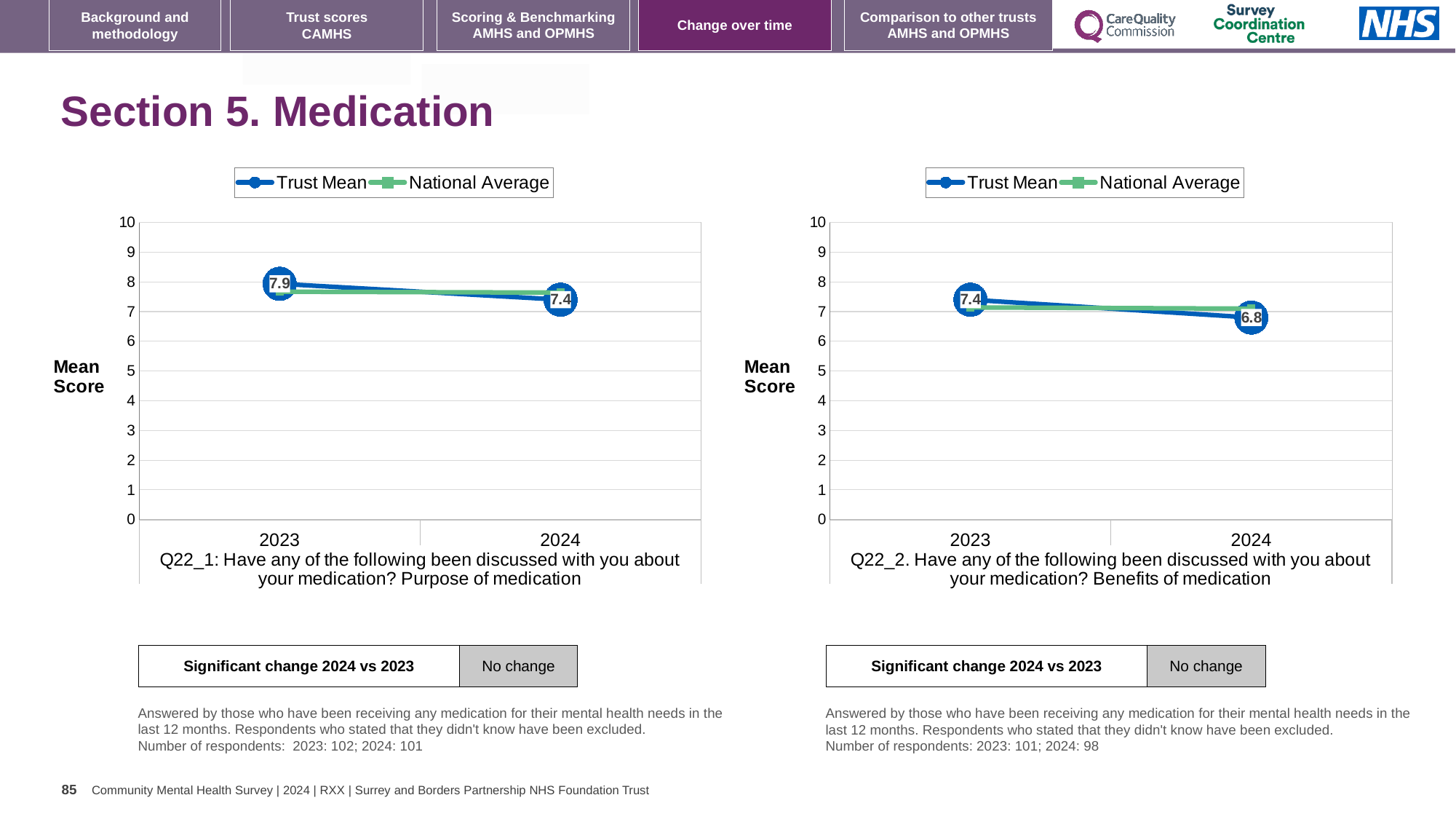
In the left chart (Q22_1: Purpose of medication), what is the Trust Mean for 2024? 7.4 In the right chart (Q22_2: Benefits of medication), does the Trust Mean rise or fall from 2023 to 2024? fall How many years are plotted on the x axis of the right chart (Q22_2: Benefits of medication)? 2 How many series does the legend of the left chart (Q22_1: Purpose of medication) list? 2 In the right chart (Q22_2: Benefits of medication), what is the Trust Mean for 2023? 7.4 In the left chart (Q22_1: Purpose of medication), what is the Trust Mean for 2023? 7.9 What kind of chart is the left chart (Q22_1: Purpose of medication)? line chart In the right chart (Q22_2: Benefits of medication), what is the Trust Mean for 2024? 6.8 In the left chart (Q22_1: Purpose of medication), which year has the higher Trust Mean, 2023 or 2024? 2023 In the right chart (Q22_2: Benefits of medication), what is the difference between the Trust Mean in 2023 and in 2024? 0.6 In the left chart (Q22_1: Purpose of medication), is the National Average for 2023 greater or less than 8? less In the left chart (Q22_1: Purpose of medication), by how much did the Trust Mean change from 2023 to 2024? 0.5